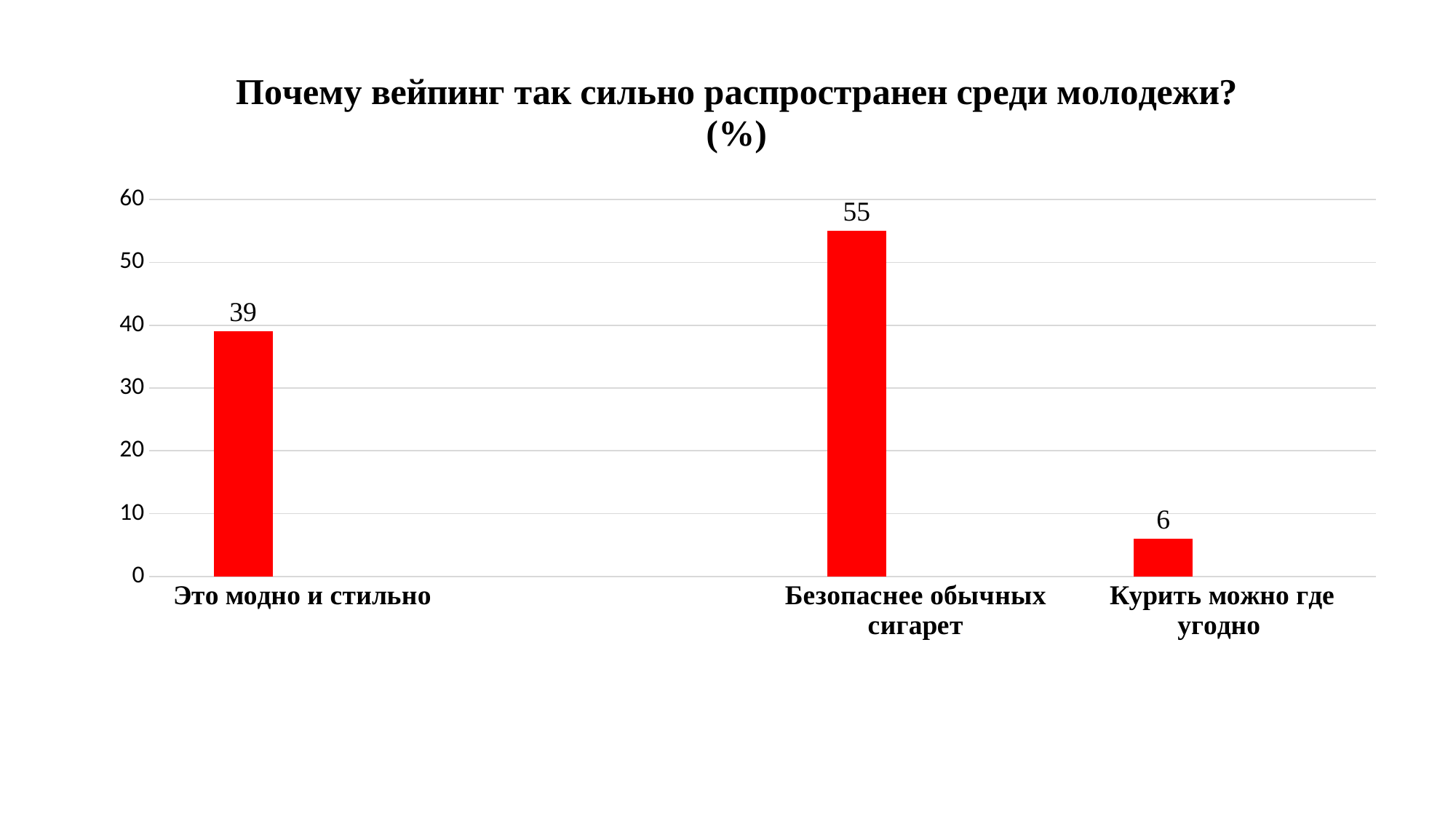
How many categories are shown in the chart? 3 Which is larger: the value for "Это модно и стильно" or the value for "Курить можно где угодно"? Это модно и стильно What is the difference between the values for "Это модно и стильно" and "Курить можно где угодно"? 33 What is the value for "Безопаснее обычных сигарет"? 55 What is the title of the chart? Почему вейпинг так сильно распространен среди молодежи? (%) Which category has the lowest value? Курить можно где угодно What is the value for "Курить можно где угодно"? 6 What kind of chart is shown on the slide? bar chart What is the difference between the values for "Безопаснее обычных сигарет" and "Это модно и стильно"? 16 Which category has the highest value? Безопаснее обычных сигарет What is the value for "Это модно и стильно"? 39 Is the value for "Безопаснее обычных сигарет" greater or less than 50? greater